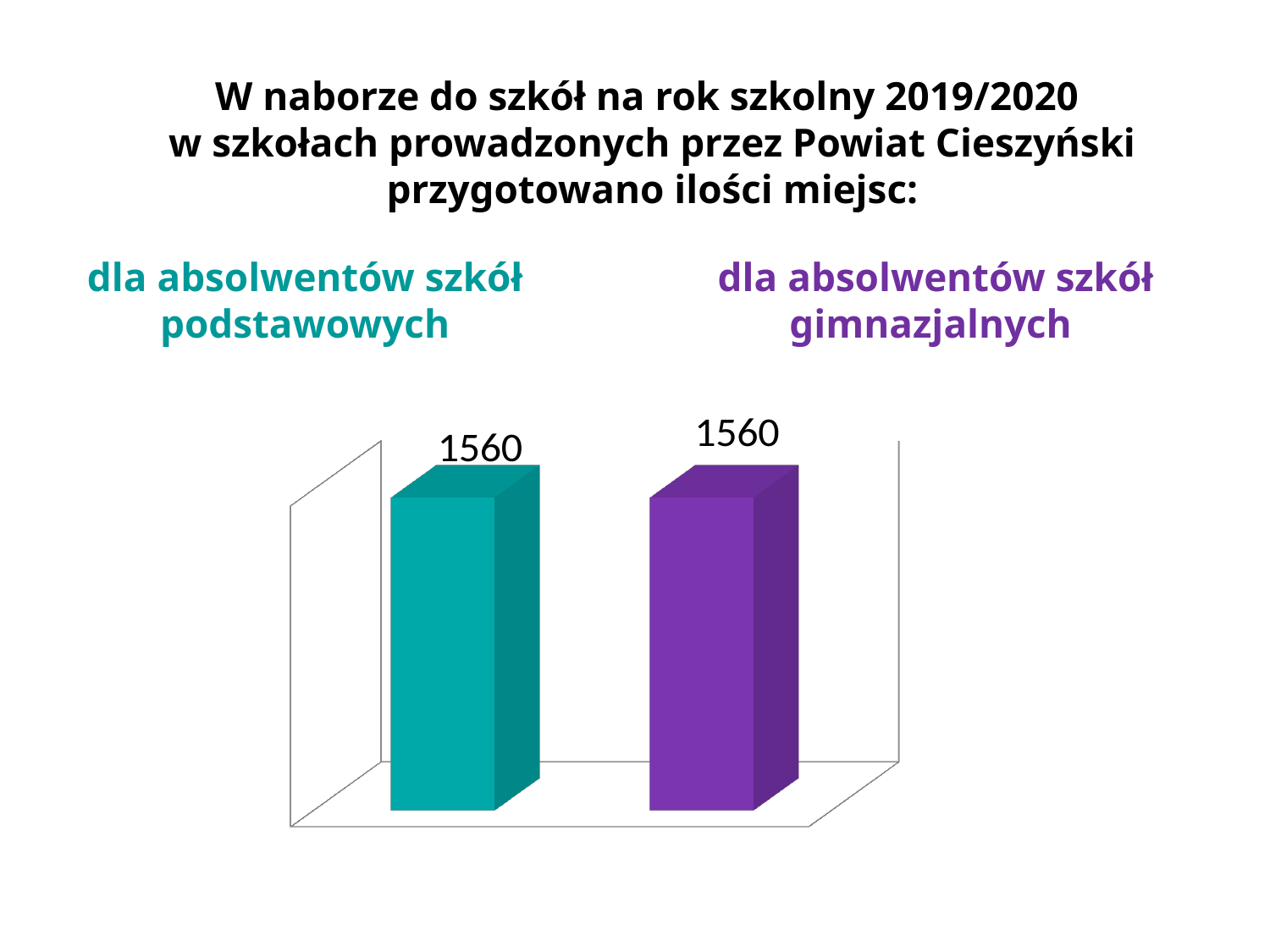
Are the values for primary school graduates and lower secondary school graduates the same or different? the same What colour is the bar for graduates of primary schools (szkół podstawowych)? teal How many bars are plotted on the chart? 2 What colour is the bar for graduates of lower secondary schools (szkół gimnazjalnych)? purple What kind of chart is shown on the slide? bar chart What is the difference between the number of places for primary school graduates and for lower secondary school graduates? 0 How many places are shown for graduates of lower secondary schools (dla absolwentów szkół gimnazjalnych)? 1560 How many places are shown for graduates of primary schools (dla absolwentów szkół podstawowych)? 1560 Which school year does the chart refer to? 2019/2020